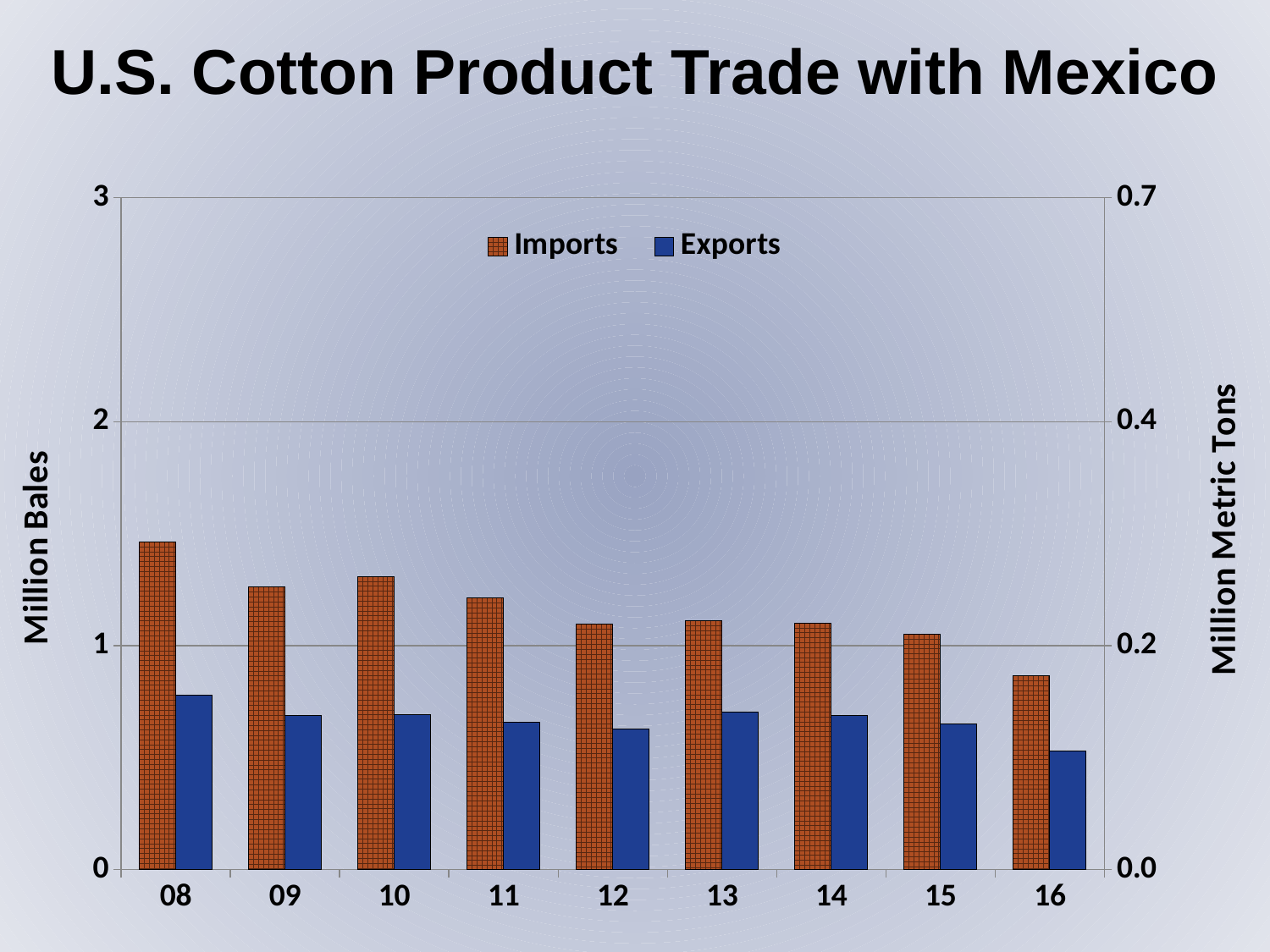
In which year are Imports highest? 08 In which year are Exports lowest? 16 Which is larger in 12, Imports or Exports? Imports Is the Imports value for 16 greater or less than 1 million bales? less What is the title of the chart? U.S. Cotton Product Trade with Mexico In which year are Imports lowest? 16 Is the Imports value for 08 greater or less than 1 million bales? greater What kind of chart is shown on the slide? bar chart In which year are Exports highest? 08 How many series does the legend list? 2 Do Imports generally rise or fall from 08 to 16? fall How many years are shown on the x axis? 9